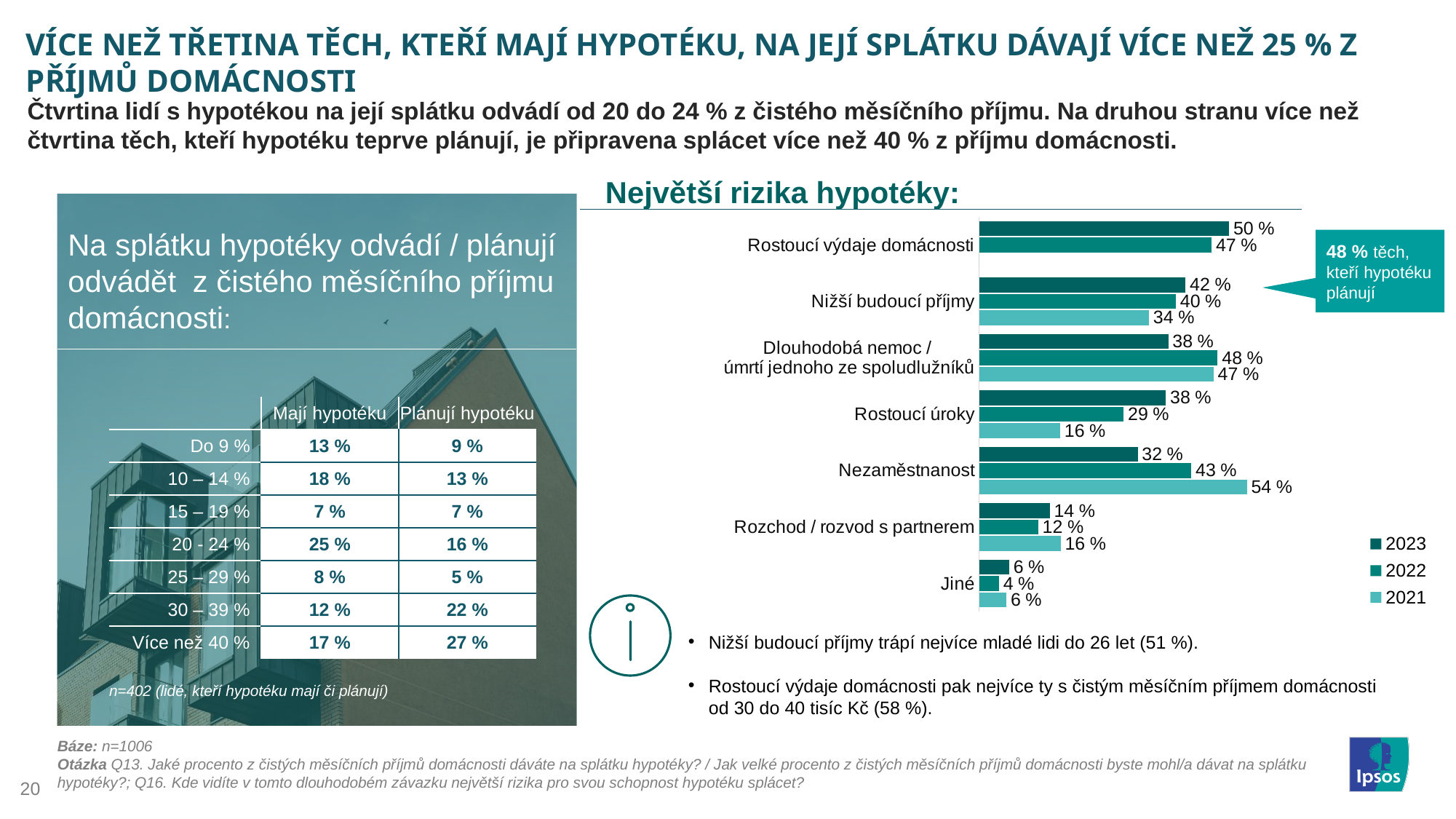
In the chart 'Největší rizika hypotéky', which years are listed in the legend? 2023, 2022, 2021 In the chart 'Největší rizika hypotéky', how many risk categories are shown? 7 In the chart 'Největší rizika hypotéky', which category has the lowest 2022 value? Jiné In the chart 'Největší rizika hypotéky', what is the 2021 value for 'Nezaměstnanost'? 54 % In the chart 'Největší rizika hypotéky', which category has the highest 2023 value? Rostoucí výdaje domácnosti In the chart 'Největší rizika hypotéky', what is the 2022 value for 'Rostoucí úroky'? 29 % In the chart 'Největší rizika hypotéky', which is larger for 'Rostoucí úroky': the 2023 value or the 2021 value? 2023 What type of chart is 'Největší rizika hypotéky'? Bar chart In the chart 'Největší rizika hypotéky', what is the difference between the 2021 and 2023 values for 'Nezaměstnanost'? 22 % In the chart 'Největší rizika hypotéky', how many series does the legend list? 3 In the chart 'Největší rizika hypotéky', what is the 2023 value for 'Rostoucí výdaje domácnosti'? 50 % In the chart 'Největší rizika hypotéky', what is the difference between the 2022 and 2023 values for 'Dlouhodobá nemoc / úmrtí jednoho ze spoludlužníků'? 10 %